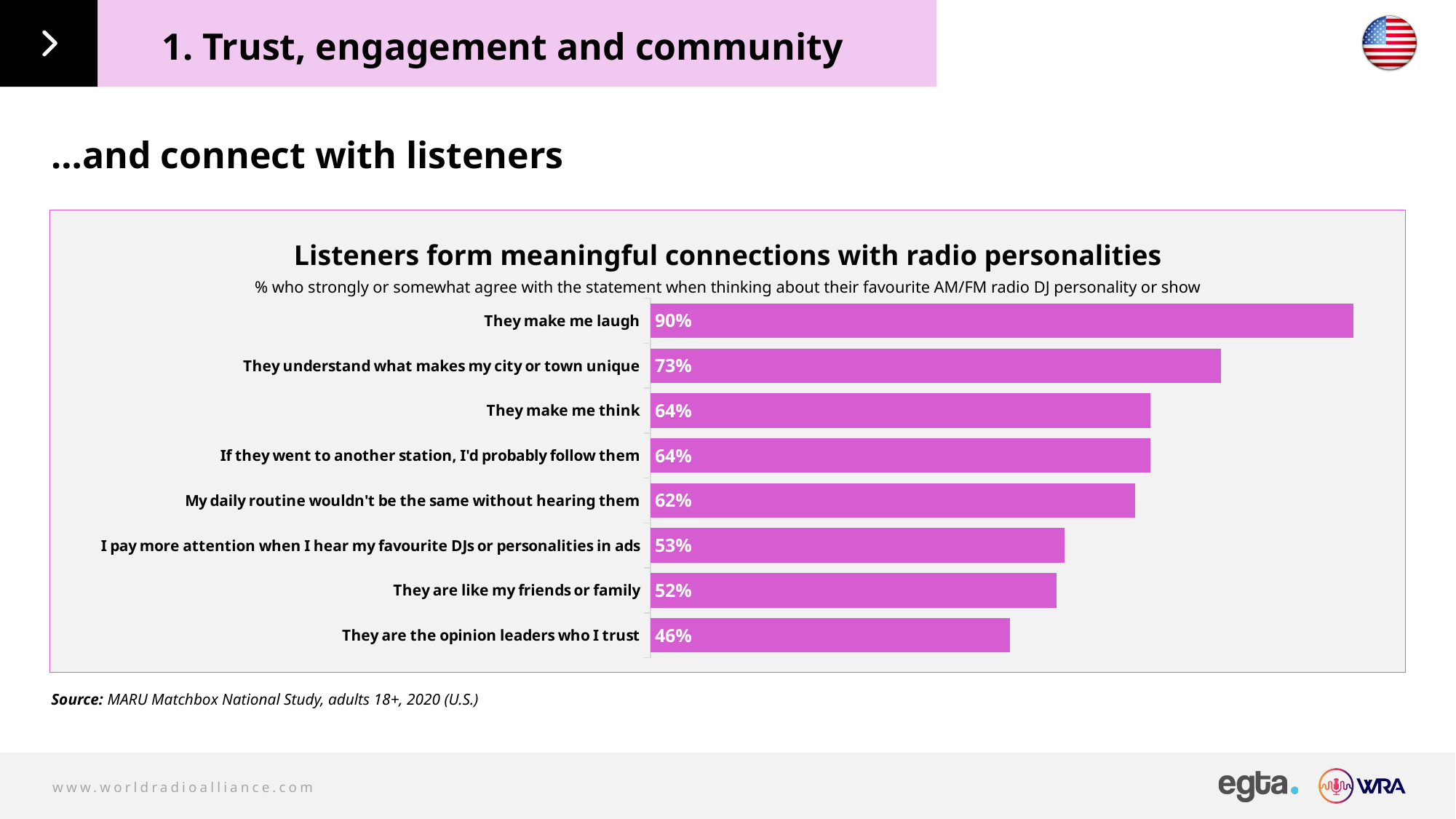
Which is larger: the value for "My daily routine wouldn't be the same without hearing them" or "They are like my friends or family"? My daily routine wouldn't be the same without hearing them What is the value for "I pay more attention when I hear my favourite DJs or personalities in ads"? 53% What is the difference between "They understand what makes my city or town unique" and "They make me think"? 9% What is the difference between the values for "They make me laugh" and "They are the opinion leaders who I trust"? 44% What is the title of the chart? Listeners form meaningful connections with radio personalities What percentage agree that "They understand what makes my city or town unique"? 73% Which statement has the highest level of agreement? They make me laugh How many statements are shown in the chart? 8 Which statement has the lowest level of agreement? They are the opinion leaders who I trust What type of chart is shown on the slide? Bar chart What is the value for "They are the opinion leaders who I trust"? 46% What percentage of listeners agree with the statement "They make me laugh"? 90%